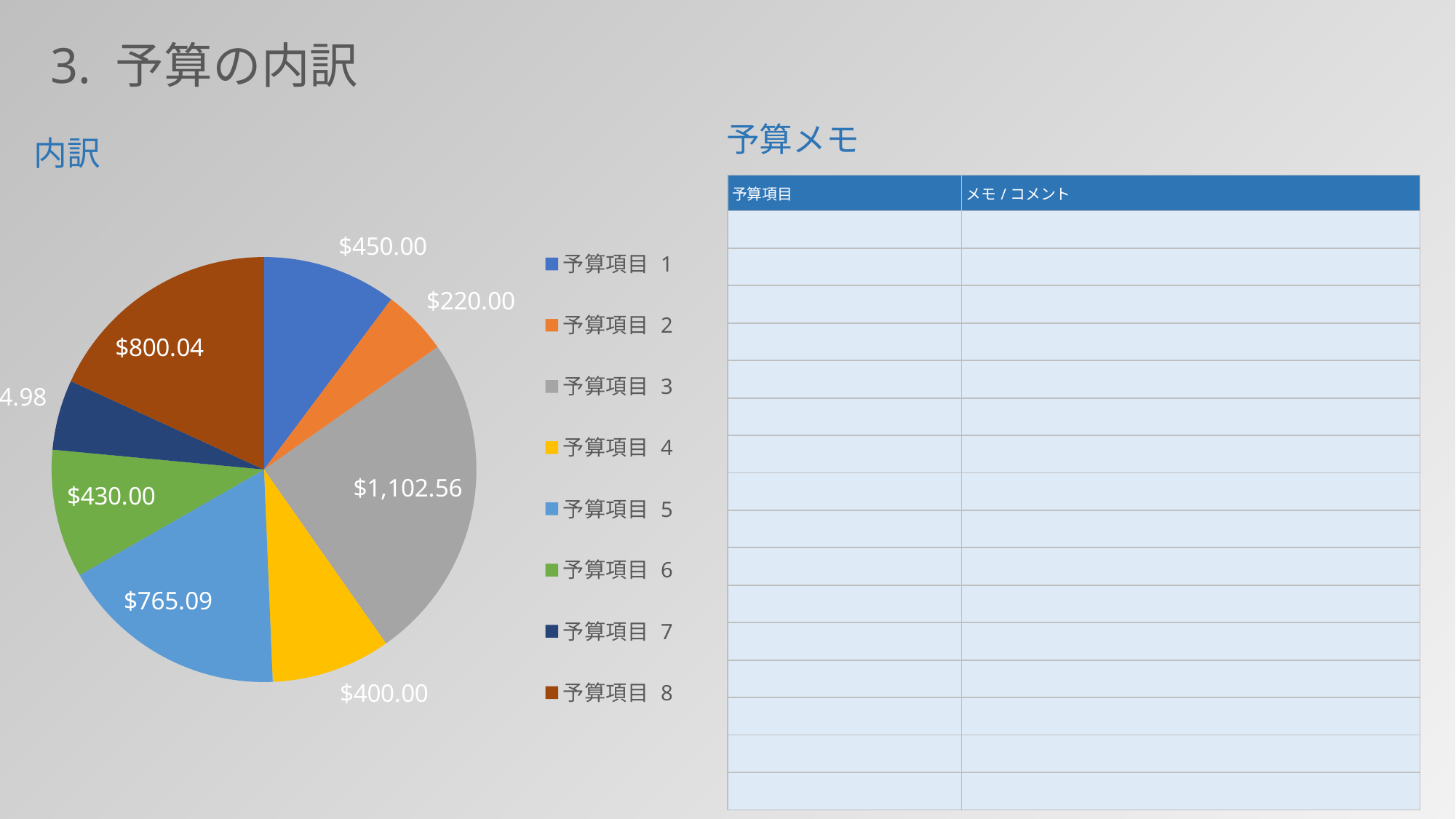
Which is larger in the pie chart, the value for 予算項目 5 or 予算項目 4? 予算項目 5 What is the value for 予算項目 8 in the pie chart? $800.04 What is the difference between the values for 予算項目 3 and 予算項目 8? $302.52 What is the value for 予算項目 2 in the pie chart? $220.00 What colour is the slice for 予算項目 6 in the pie chart? green What is the value for 予算項目 5 in the pie chart? $765.09 What is the difference between the values for 予算項目 1 and 予算項目 2? $230.00 Which budget item has the largest slice in the pie chart? 予算項目 3 What kind of chart is shown under the heading 内訳? pie chart What is the value for 予算項目 4 in the pie chart? $400.00 What is the value for 予算項目 3 in the pie chart? $1,102.56 How many budget items does the legend of the pie chart list? 8